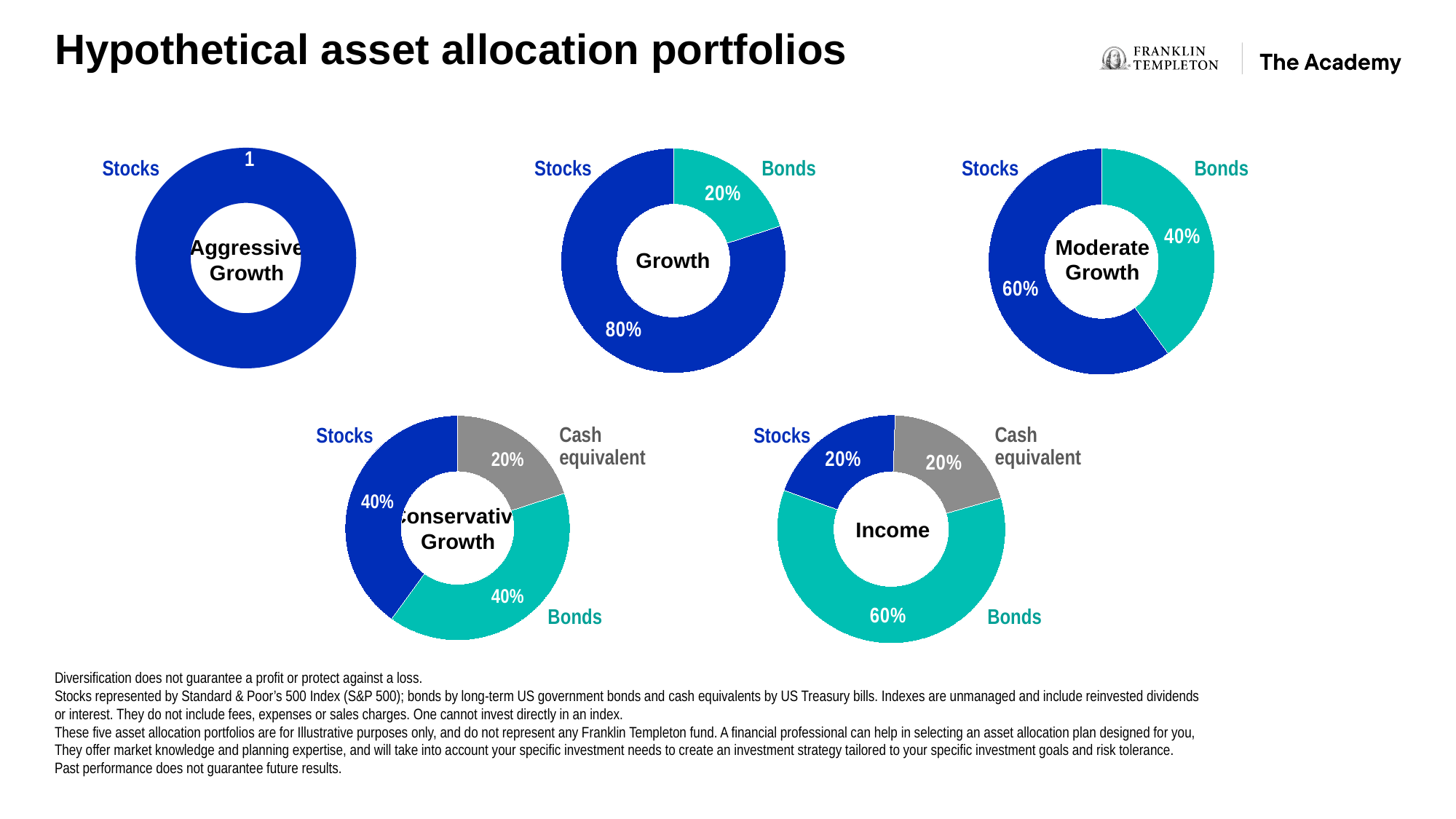
In the Growth chart, which asset class has the smallest share? Bonds In the Income chart, what share is allocated to Bonds? 60% In the Moderate Growth chart, what share is allocated to Stocks? 60% What kind of chart is used for the Growth portfolio? Donut chart In the Income chart, which asset class has the largest share? Bonds In the Moderate Growth chart, what share is allocated to Bonds? 40% In the Moderate Growth chart, what is the difference between the Stocks share and the Bonds share? 20% In the Income chart, which is larger, the Stocks share or the Bonds share? Bonds In the Growth chart, what share is allocated to Stocks? 80% How many asset classes are shown in the Conservative Growth chart? 3 In the Conservative Growth chart, what share is allocated to Cash equivalent? 20% In the Growth chart, what share is allocated to Bonds? 20%